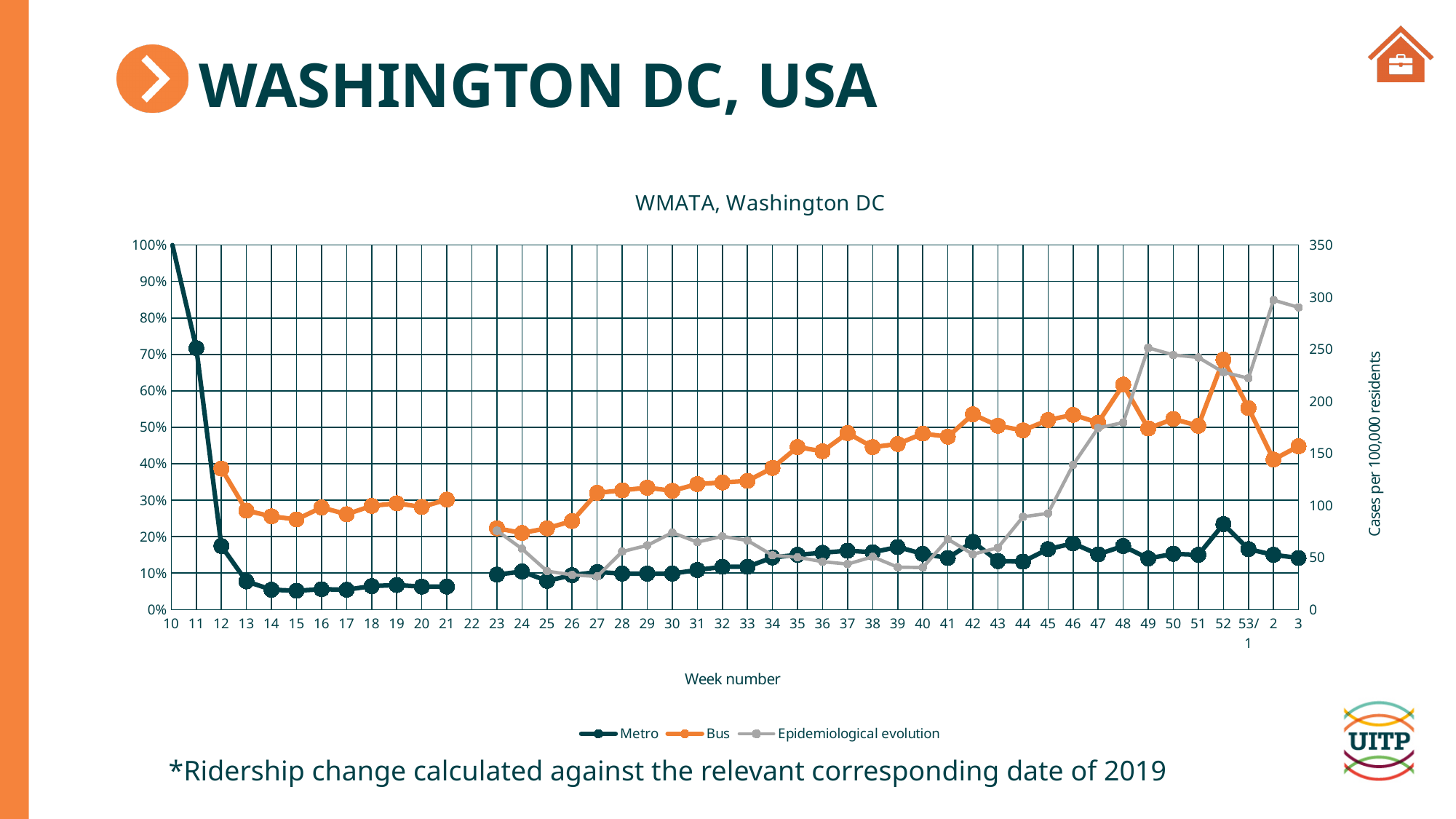
At week 30, which series has the larger value, Bus or Metro? Bus Is the Epidemiological evolution value at week 23 greater or less than 100 cases per 100,000 residents? less How many series does the legend list? 3 Is the Metro value at week 14 greater or less than 10%? less What is the title of the chart? WMATA, Washington DC What type of chart is shown on the slide? Line chart At which week does the Epidemiological evolution series reach its highest value? 2 What is the label of the right-hand vertical axis? Cases per 100,000 residents Does the Metro series rise or fall between week 10 and week 14? Fall Is the Bus value at week 12 greater or less than 30%? greater At which week is the Metro series at its highest? 10